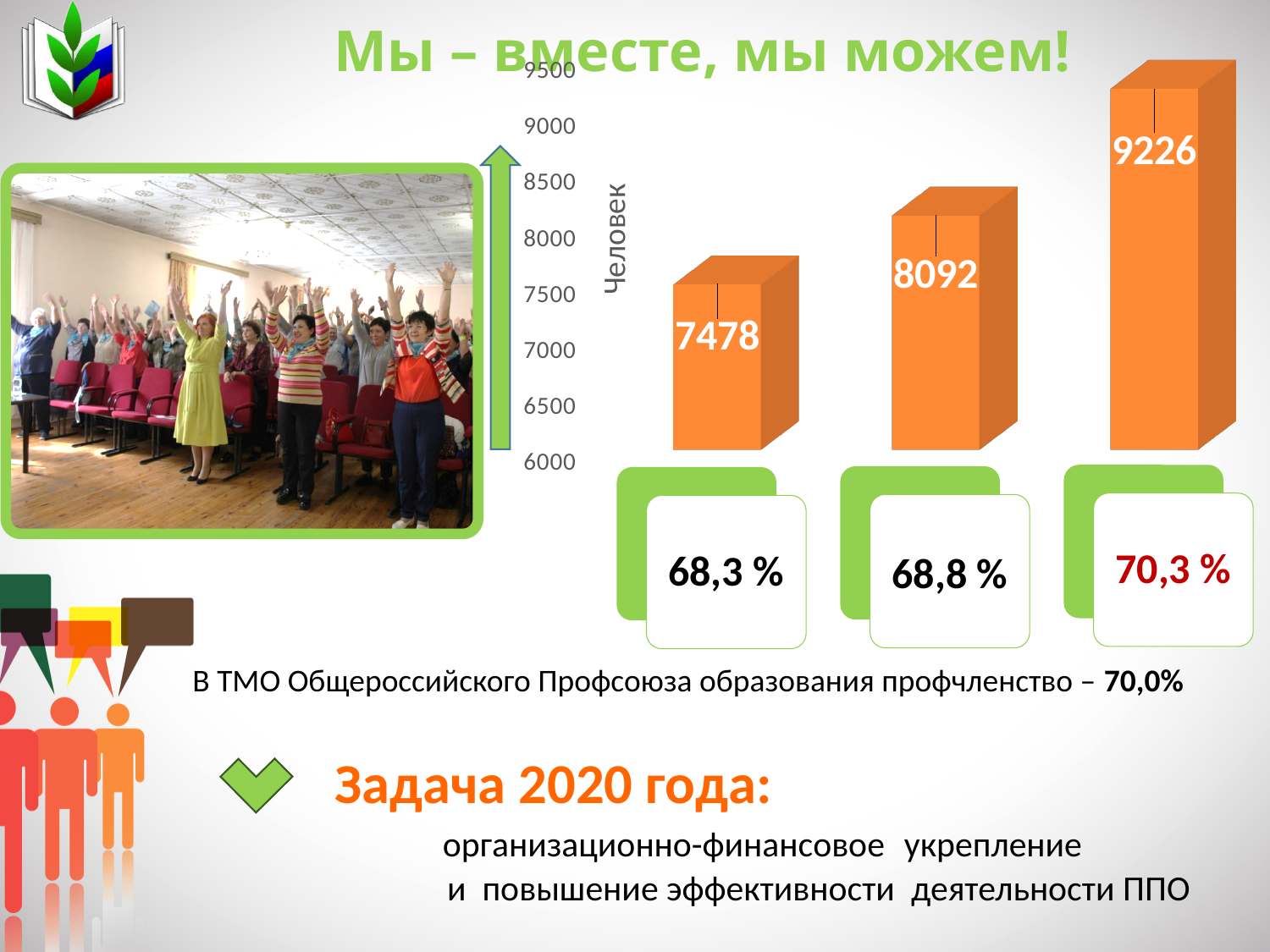
Do the bar values rise or fall from left to right? rise What is the value shown on the rightmost bar of the chart? 9226 Which bar has the highest value: the left, middle or right one? the right one What is the value shown on the leftmost bar of the chart? 7478 What kind of chart is shown on the slide? bar chart What is the value shown on the middle bar of the chart? 8092 How many bars are plotted in the chart? 3 Which is larger, the value of the middle bar or the value of the leftmost bar? the middle bar Which bar has the lowest value: the left, middle or right one? the left one Is the value of the rightmost bar greater or less than 9000? greater What is the difference between the middle bar (8092) and the leftmost bar (7478)? 614 What is the difference between the rightmost bar (9226) and the leftmost bar (7478)? 1748